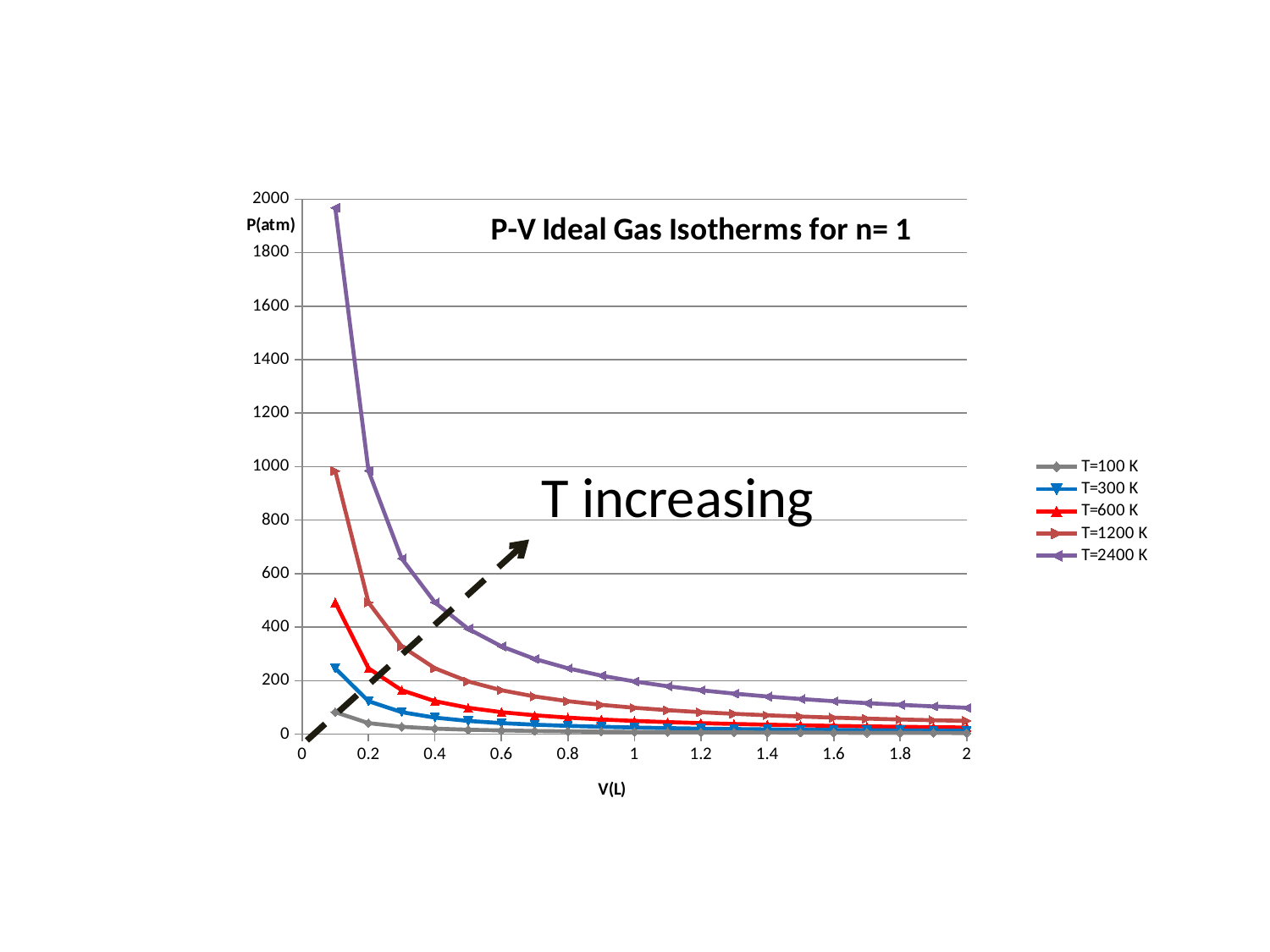
What kind of chart is shown on the slide? line chart Is the value for T=300 K at V = 0.1 greater or less than 200? greater How many series does the legend list? 5 Is the value for T=600 K at V = 0.1 greater or less than 400? greater Which series has the lowest pressure across the chart? T=100 K What is the title of the chart? P-V Ideal Gas Isotherms for n= 1 What is the label of the x axis? V(L) Which series has the highest pressure at V = 0.1? T=2400 K At V = 0.2, which is larger: the value for T=1200 K or the value for T=600 K? T=1200 K Is the value for T=100 K at V = 0.1 greater or less than 200? less Do the values of the T=2400 K series rise or fall as V increases? fall